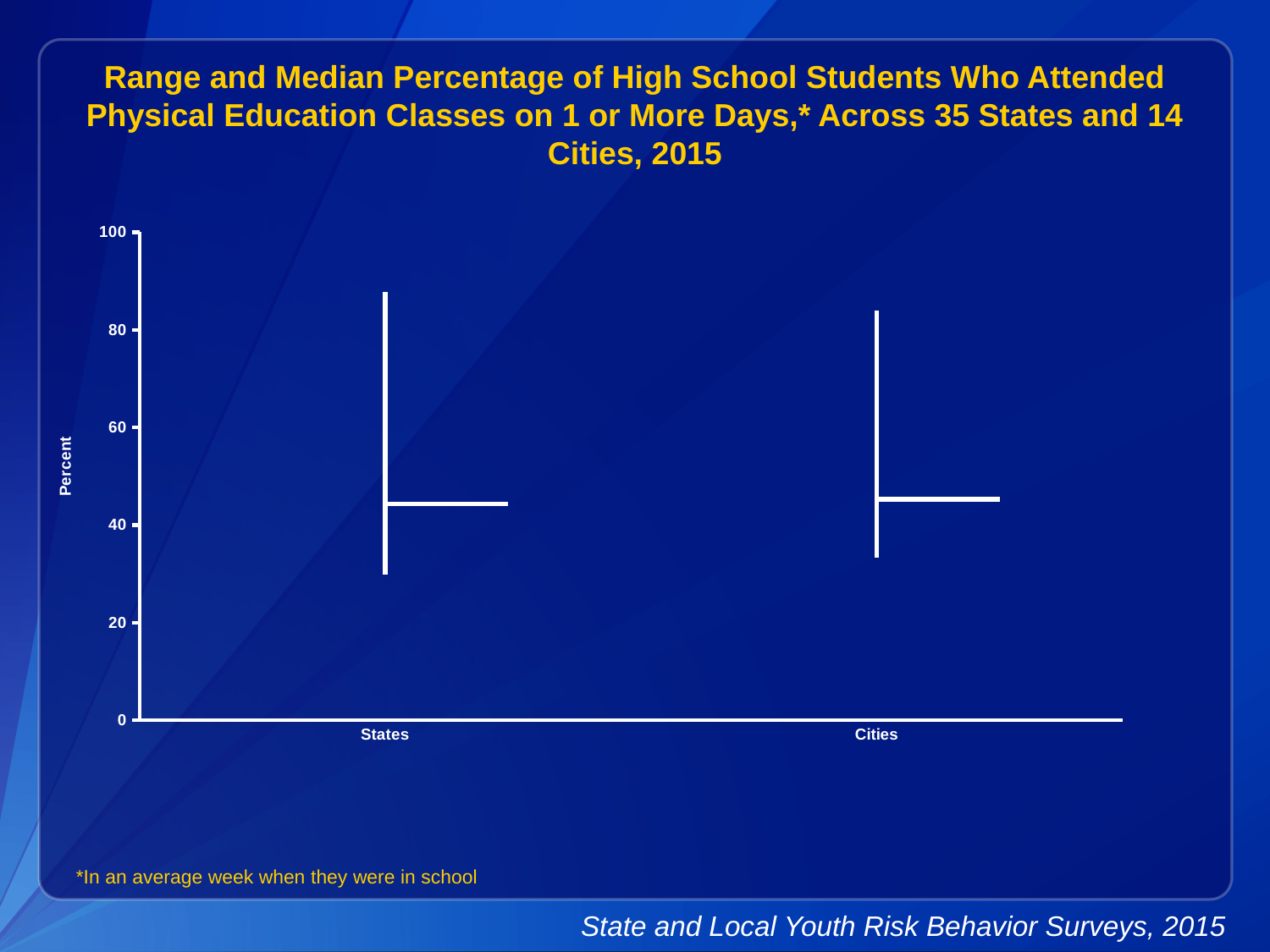
Is the median value for States greater or less than 60? less What are the two categories shown on the x axis? States and Cities Is the top of the range for States greater or less than 80? greater Is the median value for Cities greater or less than 60? less What is the highest value shown on the y axis of the chart? 100 What is the label on the y axis of the chart? Percent How many categories are shown on the x axis of the chart? 2